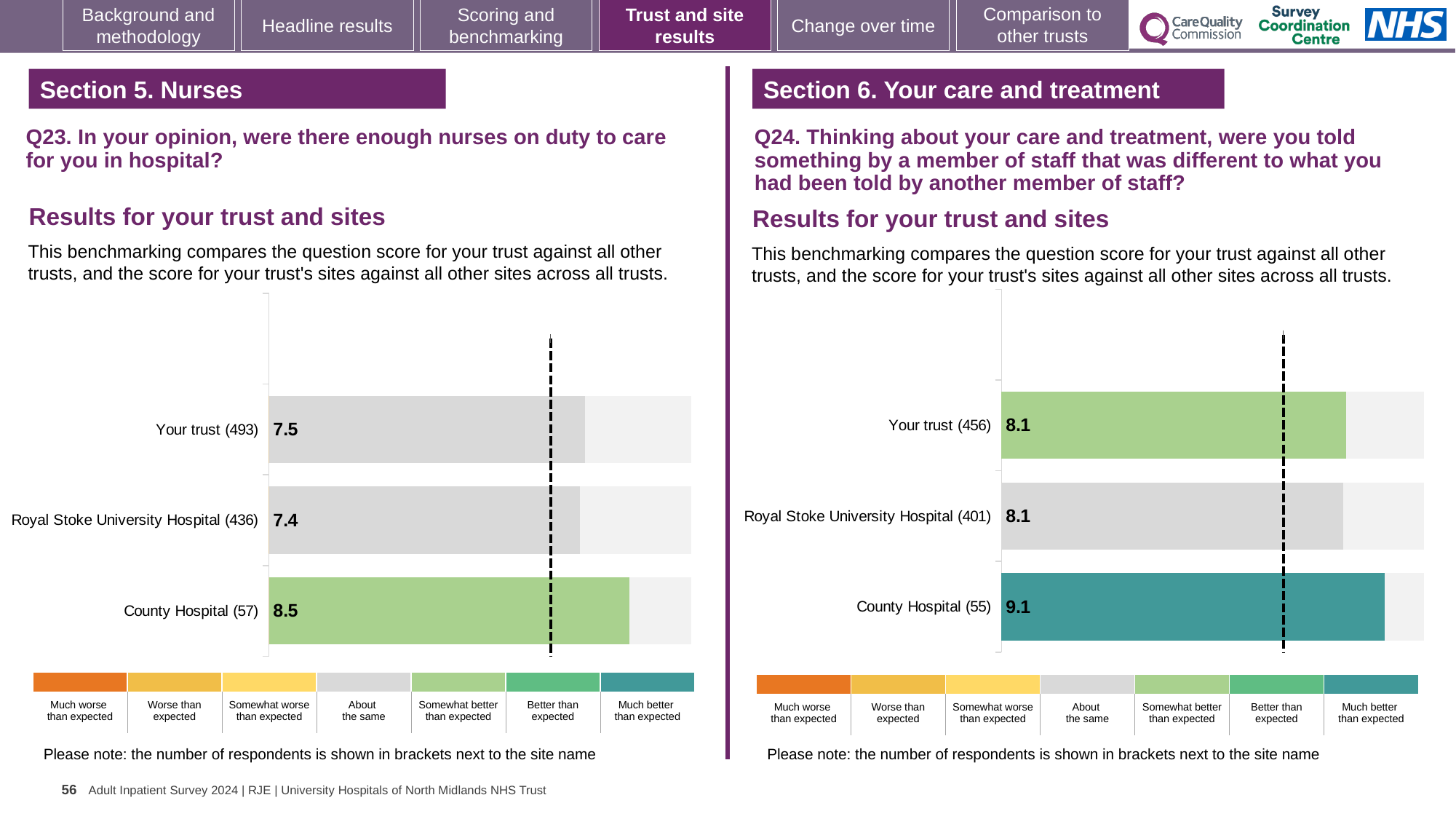
On the Q24 chart (right), which benchmark category does the colour of the County Hospital (55) bar represent? Much better than expected On the Q23 chart (left), what is the difference between the County Hospital score and the Your trust score? 1.0 On the Q23 chart (left), which site or trust has the highest score? County Hospital (57) On the Q24 chart (right), what is the score for County Hospital (55)? 9.1 How many bars are plotted on the Q23 chart (left)? 3 On the Q23 chart (left), which site or trust has the lowest score? Royal Stoke University Hospital (436) On the Q24 chart (right), what is the difference between the County Hospital score and the Your trust score? 1.0 On the Q24 chart (right), what is the score for Royal Stoke University Hospital (401)? 8.1 What type of chart is used for the Q24 results (right)? Bar chart On the Q24 chart (right), which site or trust has the highest score? County Hospital (55) On the Q23 chart (left), what is the score for County Hospital (57)? 8.5 On the Q23 chart (left), what is the score for Your trust (493)? 7.5